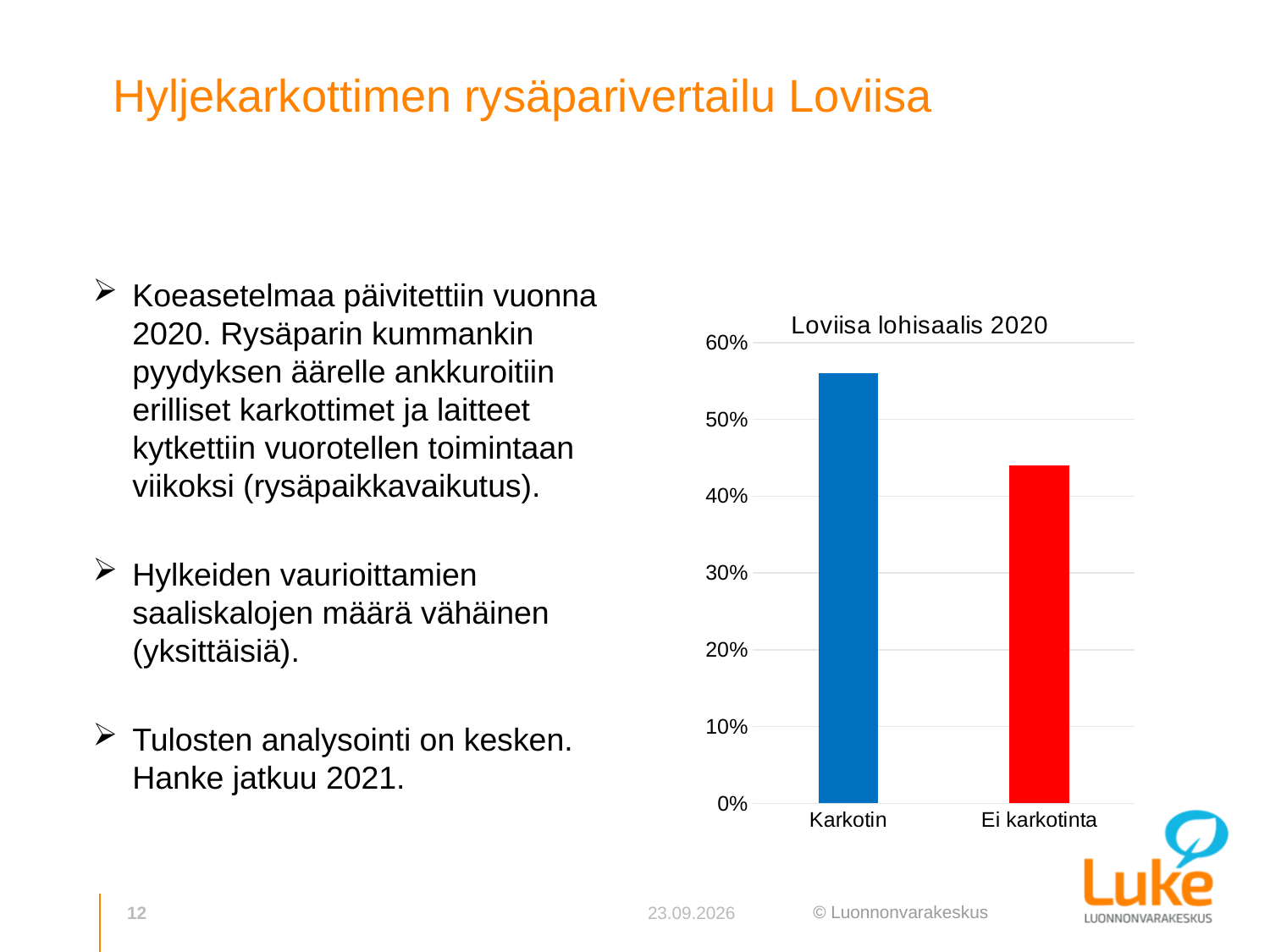
What kind of chart is shown on the slide? bar chart What colour is the bar for Ei karkotinta? red Which category has the lowest value in the chart? Ei karkotinta Which is larger, the value for Karkotin or the value for Ei karkotinta? Karkotin What is the highest value shown on the y axis of the chart? 60% Is the value for Ei karkotinta greater or less than 40%? greater What is the title of the chart? Loviisa lohisaalis 2020 Which category has the highest value in the chart? Karkotin How many categories are shown on the x axis of the chart? 2 Is the value for Ei karkotinta greater or less than 50%? less Is the value for Karkotin greater or less than 60%? less